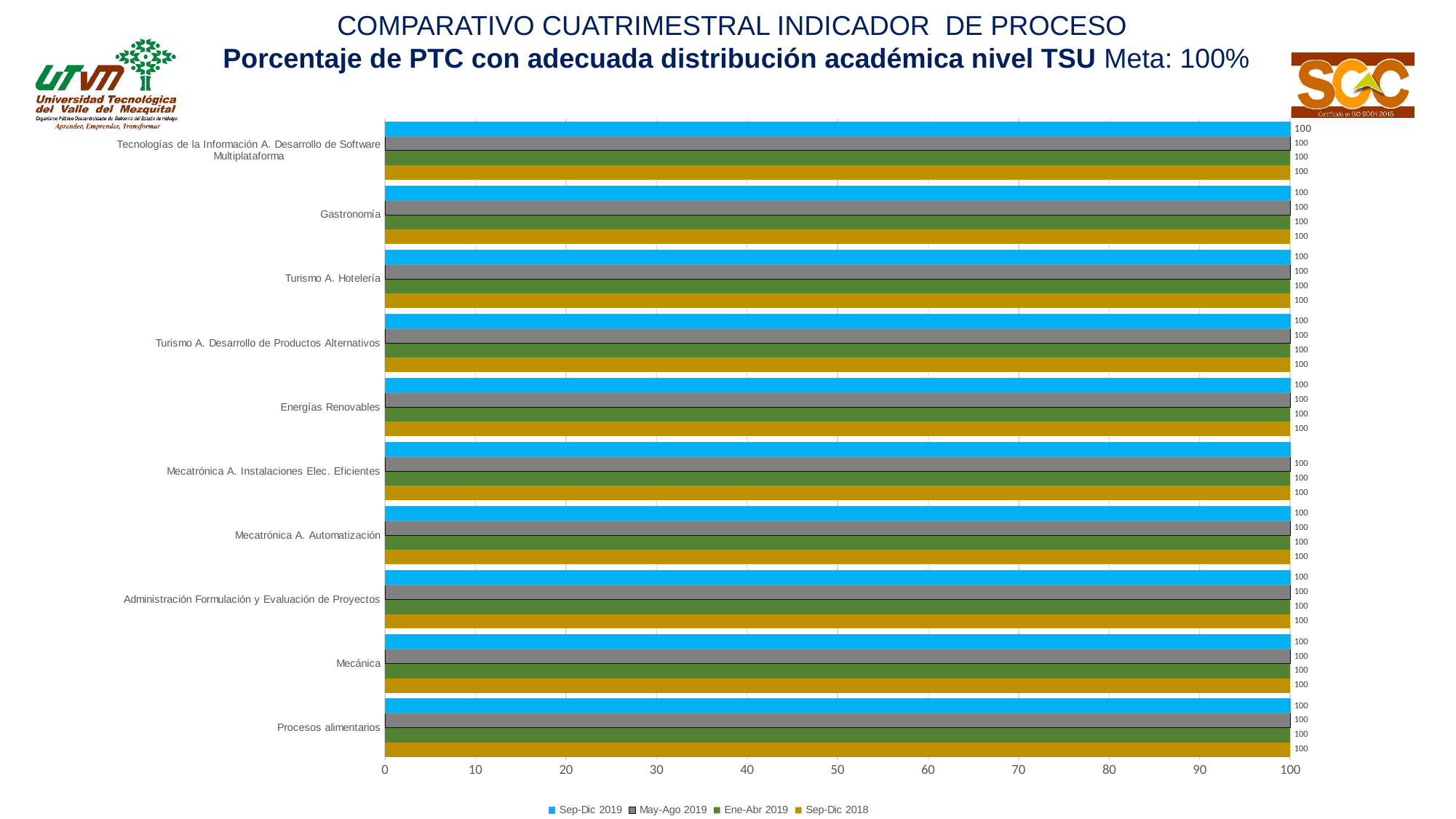
What kind of chart is shown on the slide? bar chart Which series is shown in the legend first, on the left? Sep-Dic 2019 How many categories (programs) are shown on the y axis? 10 What is the highest tick value shown on the x axis? 100 Is the value for Mecatrónica A. Automatización in the Ene-Abr 2019 series greater or less than 90? greater What is the value for Energías Renovables in the May-Ago 2019 series? 100 What is the difference between the Sep-Dic 2019 value and the Sep-Dic 2018 value for Turismo A. Hotelería? 0 What is the value for Gastronomía in the Sep-Dic 2019 series? 100 How many series does the legend list? 4 What target (Meta) is stated in the chart title? 100% What is the value for Mecánica in the Sep-Dic 2018 series? 100 What is the value for Procesos alimentarios in the Ene-Abr 2019 series? 100